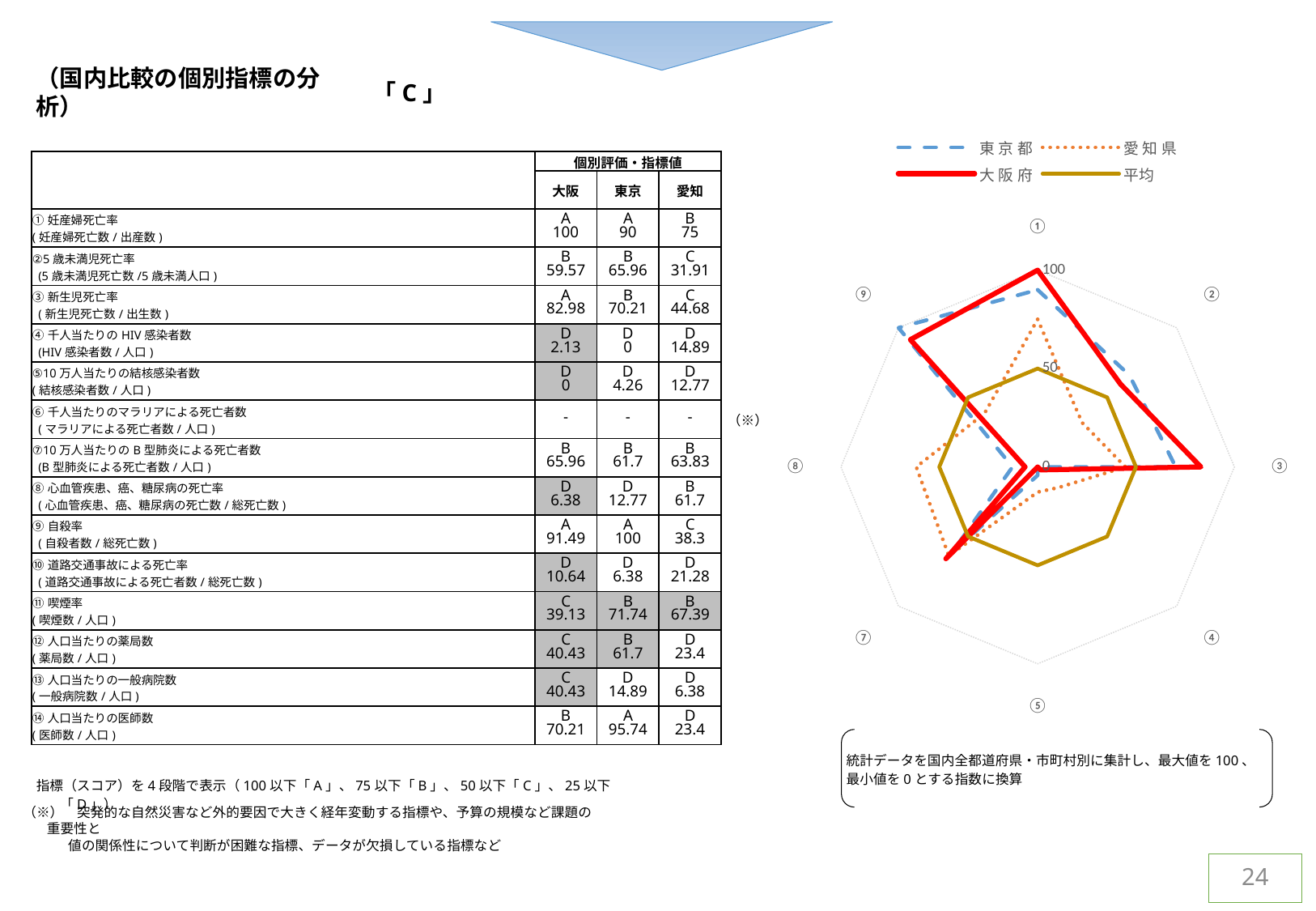
In the radar chart, on axis ①, which is larger: 大阪府 or 愛知県? 大阪府 In the radar chart, is the value for 大阪府 on axis ① greater or less than 50? greater In the radar chart, is the value for 大阪府 on axis ⑤ greater or less than 50? less What kind of chart is shown on the right side of the slide? Radar chart In the radar chart, is the value for 東京都 on axis ⑨ greater or less than 50? greater Which series are listed in the legend of the radar chart? 東京都, 愛知県, 大阪府, 平均 In the radar chart, which series is drawn as a thick solid red line? 大阪府 In the radar chart, on which axis does 大阪府 reach its highest value? ① In the radar chart, on axis ⑧, which is larger: 愛知県 or 大阪府? 愛知県 How many numbered axes (categories) does the radar chart have? 8 In the radar chart, which series has the highest value on axis ⑧? 愛知県 How many series does the legend of the radar chart list? 4